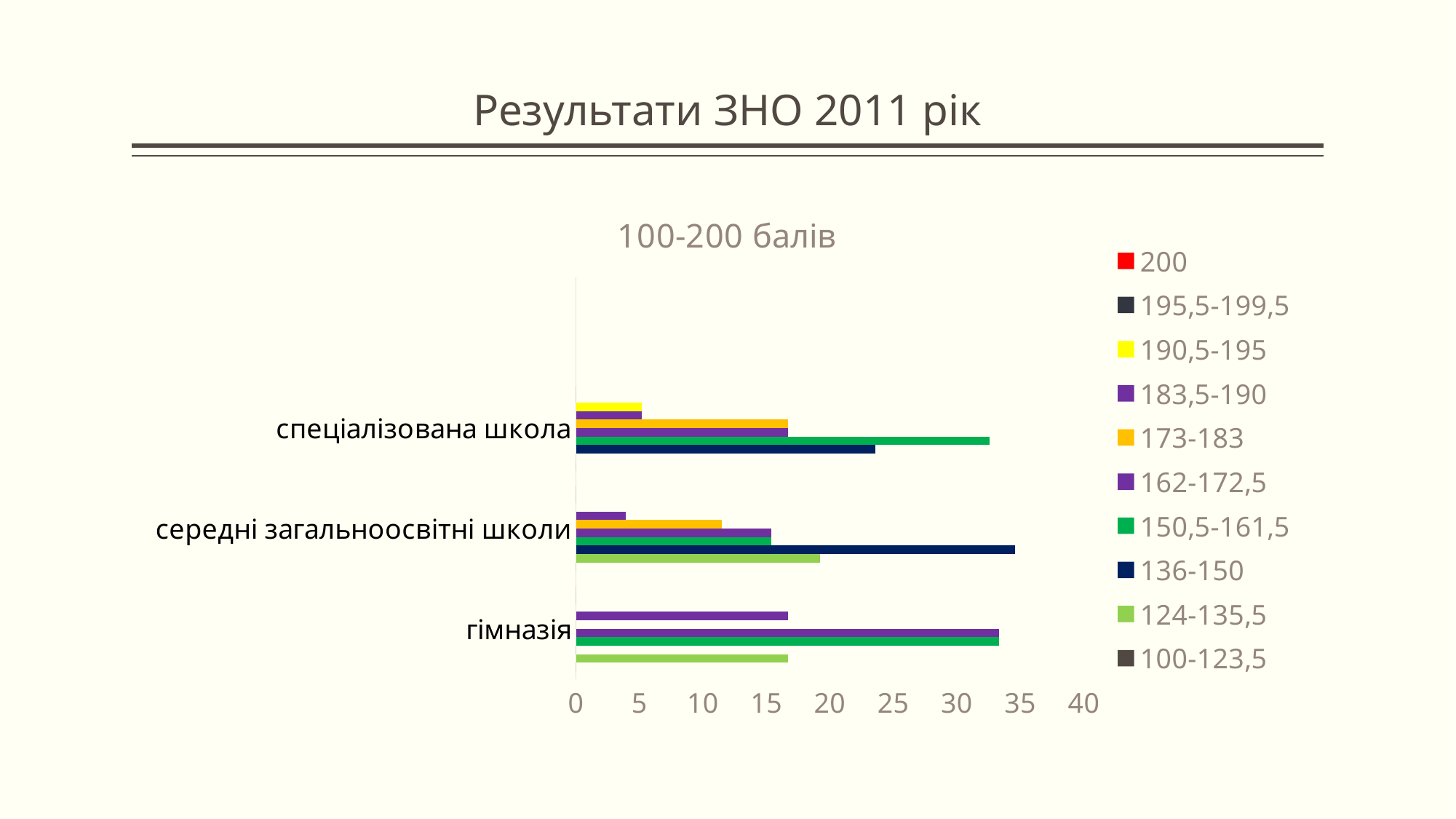
What is the title of the chart? 100-200 балів Is the value of the 136-150 series for спеціалізована школа greater or less than 20? greater Which category has the larger value for the 136-150 series: спеціалізована школа or середні загальноосвітні школи? середні загальноосвітні школи Which category has the larger value for the 150,5-161,5 series: спеціалізована школа or середні загальноосвітні школи? спеціалізована школа Is the value of the 124-135,5 series for середні загальноосвітні школи greater or less than 15? greater How many school categories are shown on the y axis of the chart? 3 Is the value of the 173-183 series for середні загальноосвітні школи greater or less than 15? less What colour is used for the 200 series in the legend? red What kind of chart is shown on the slide? bar chart How many series does the chart legend list? 10